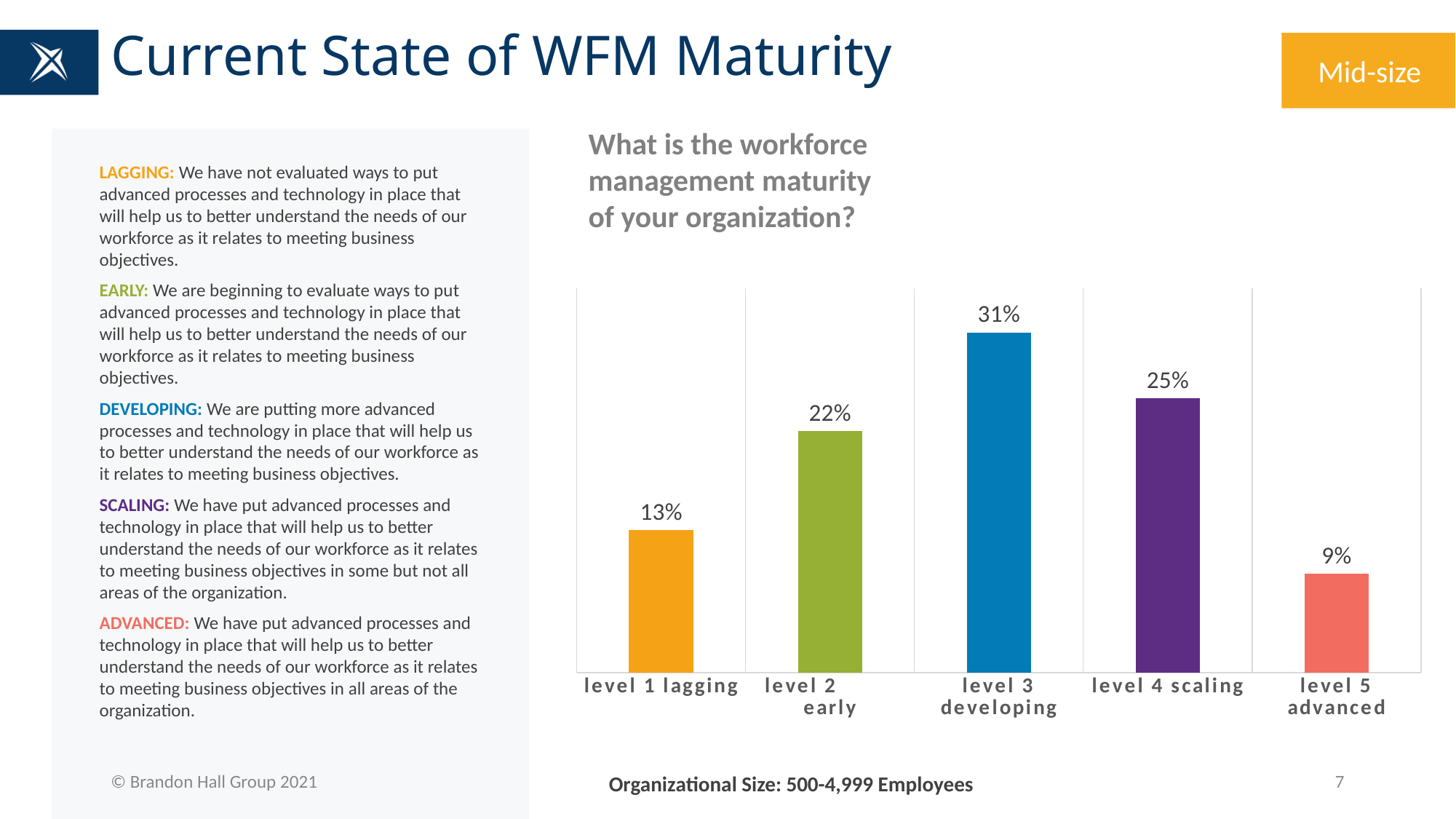
What is the difference between the values for level 3 developing and level 4 scaling? 6% What is the value shown for level 3 developing? 31% What is the difference between the values for level 2 early and level 1 lagging? 9% Which is larger, the value for level 4 scaling or the value for level 2 early? level 4 scaling What percentage of organizations are at level 1 lagging? 13% What kind of chart is shown on the slide? bar chart Which maturity level has the lowest percentage? level 5 advanced What question does the chart title ask? What is the workforce management maturity of your organization? How many maturity levels are shown on the chart? 5 Which maturity level has the highest percentage? level 3 developing What percentage is shown for level 5 advanced? 9% What colour is the bar for level 3 developing? blue